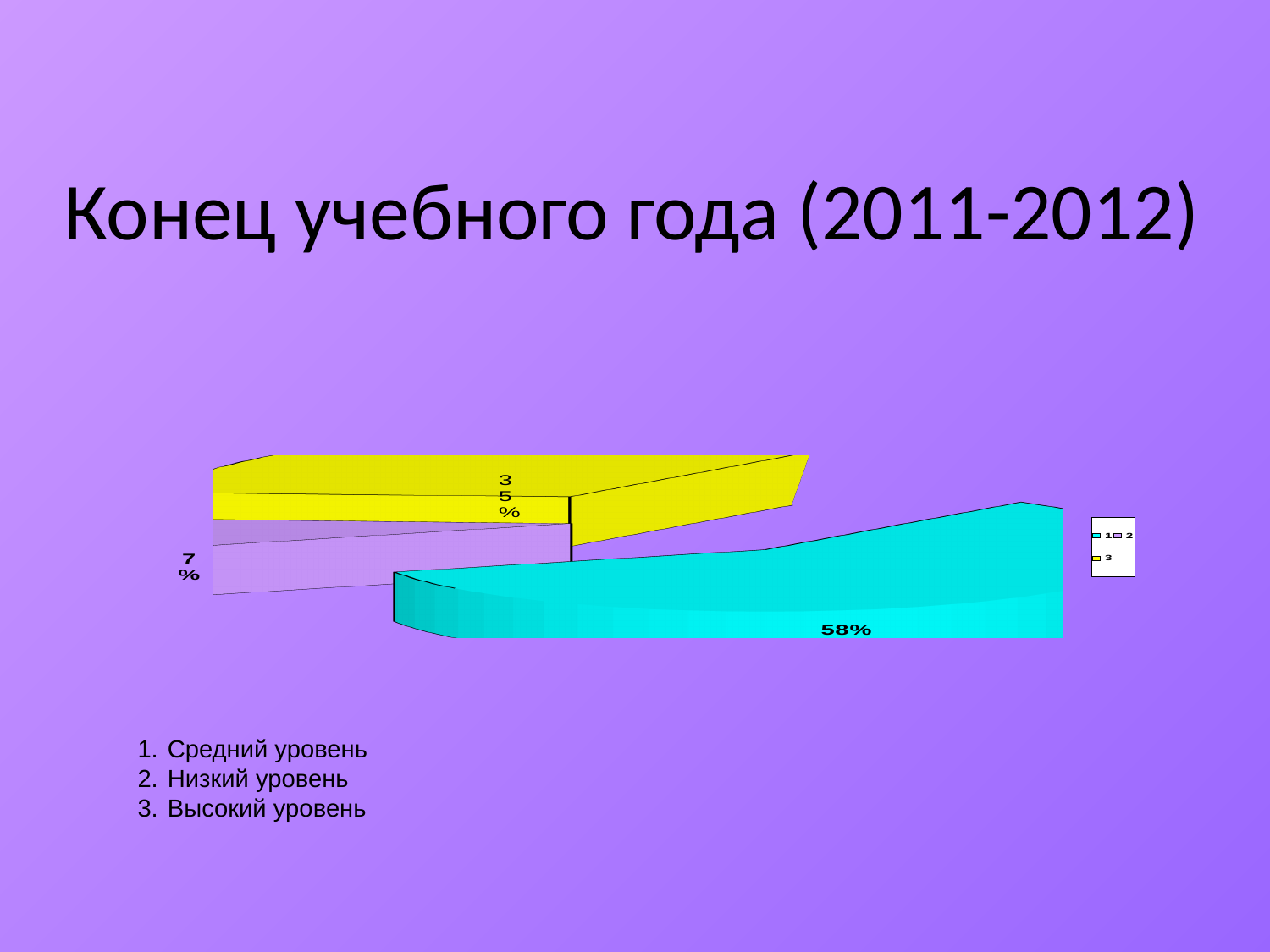
How many entries does the legend list? 3 Which slice of the pie is the smallest? 2 (Низкий уровень) What is the title of the slide containing the chart? Конец учебного года (2011-2012) What is the difference in percentage points between slice 1 and slice 3? 23 What kind of chart is shown on the slide? pie chart What share of the pie does slice 3 (Высокий уровень) have? 35% Which slice of the pie is the largest? 1 (Средний уровень) How many slices does the pie chart have? 3 What share of the pie does slice 1 (Средний уровень) have? 58% What is the difference in percentage points between slice 3 and slice 2? 28 Which is larger, the share for slice 3 or the share for slice 2? slice 3 What share of the pie does slice 2 (Низкий уровень) have? 7%